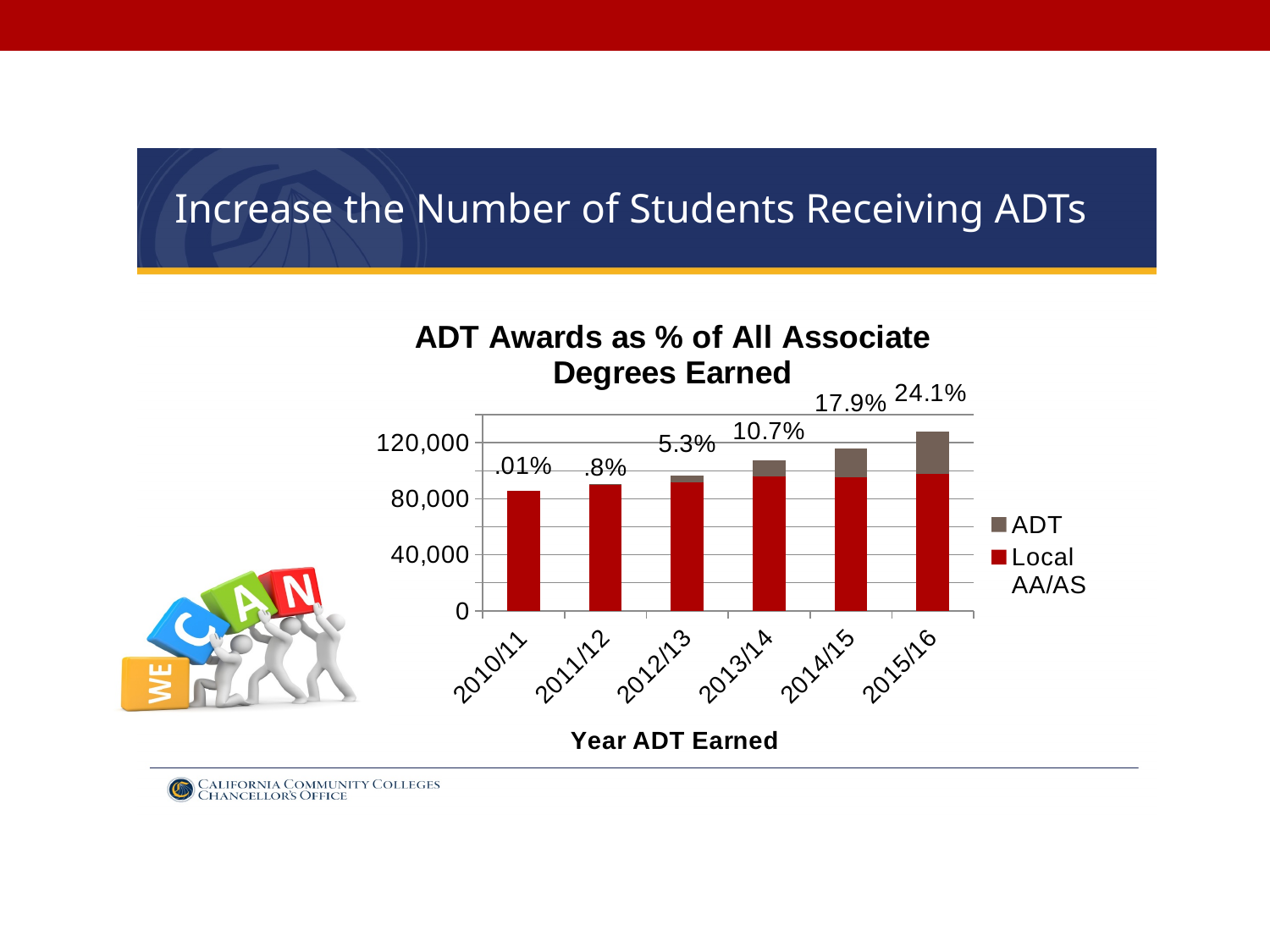
What percentage label is shown above the bar for 2015/16? 24.1% What kind of chart is shown on the slide? Stacked bar chart Do the ADT percentage labels rise or fall from 2010/11 to 2015/16? Rise Which year has the highest ADT percentage label? 2015/16 What percentage label is shown above the bar for 2010/11? .01% Is the total height of the stacked bar for 2015/16 greater or less than 120,000? greater What is the title of the x axis? Year ADT Earned What percentage label is shown above the bar for 2012/13? 5.3% How many years are shown on the x axis of the chart? 6 Which year has the lowest ADT percentage label? 2010/11 How many series does the chart's legend list? 2 What is the difference between the percentage labels for 2015/16 and 2014/15? 6.2%